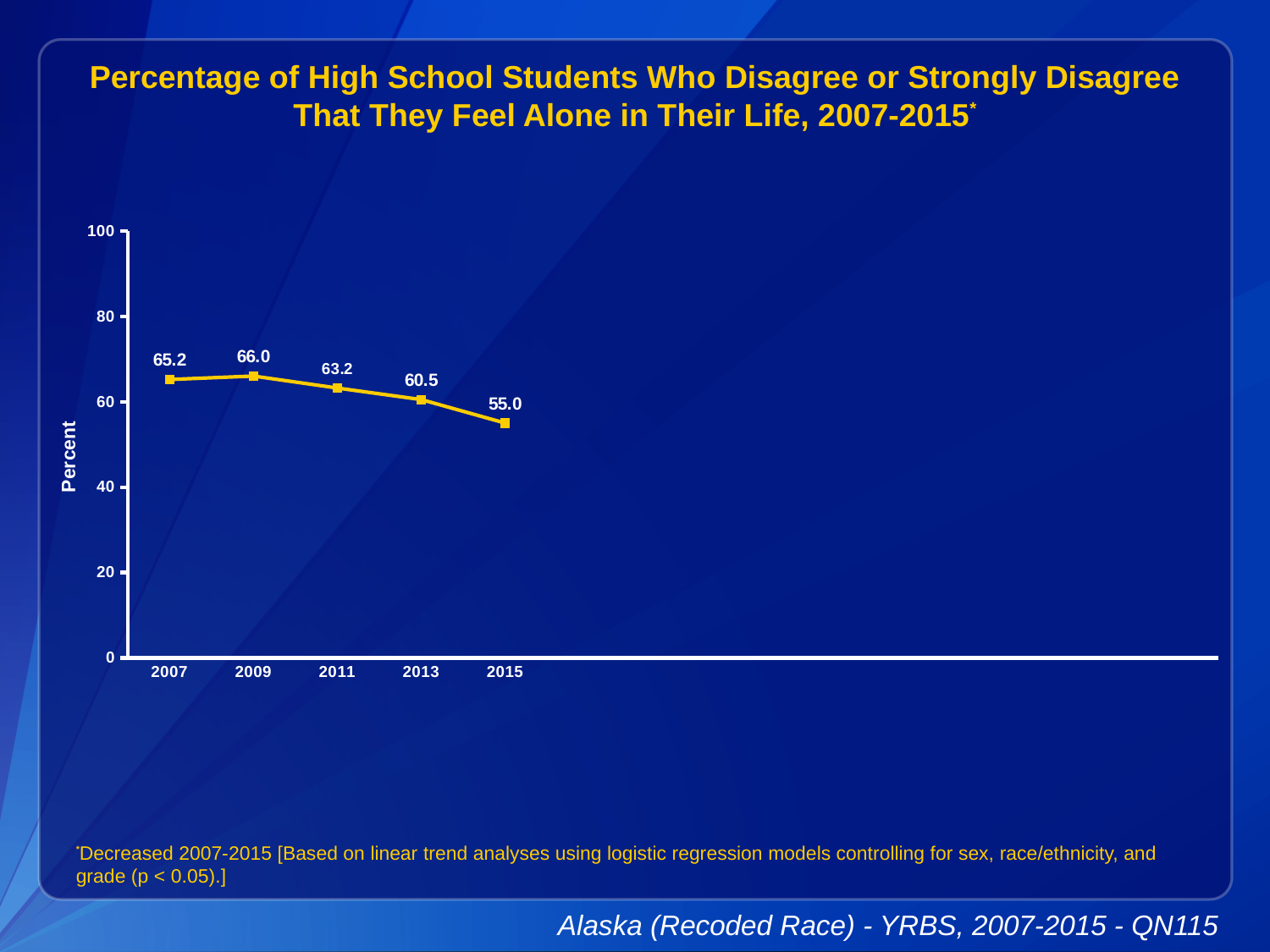
Do the values generally rise or fall from 2009 to 2015? fall What is the difference between the values for 2007 and 2015? 10.2 What is the label on the y axis? Percent What is the value for 2011? 63.2 Which is larger, the value for 2011 or the value for 2013? 2011 What kind of chart is shown? line chart What is the value for 2015? 55.0 Is the value for 2015 greater or less than 60? less Which year has the lowest value? 2015 Which year has the highest value? 2009 How many years are plotted on the chart? 5 What is the value for 2007? 65.2